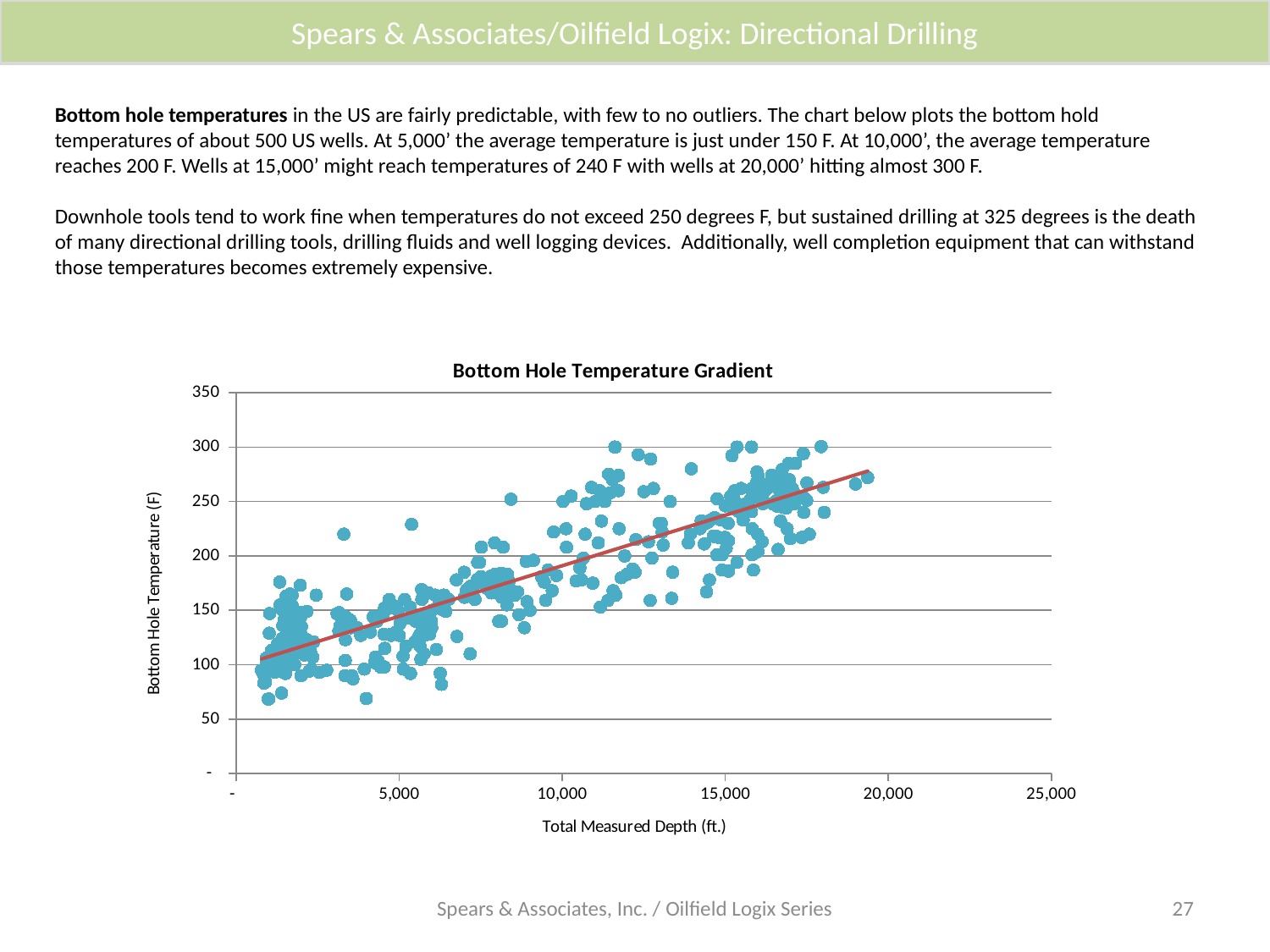
Is the trend line value at a depth of 1,000 ft greater or less than 150? less Is the trend line value at a depth of 15,000 ft greater or less than 200? greater Is the lowest plotted bottom hole temperature greater or less than 100? less What is the title of the chart on the slide? Bottom Hole Temperature Gradient Do bottom hole temperatures rise or fall as total measured depth increases along the x axis? Rise What is the label of the x axis of the chart? Total Measured Depth (ft.) What kind of chart is the Bottom Hole Temperature Gradient chart? Scatter chart What is the maximum value shown on the y axis of the chart? 350